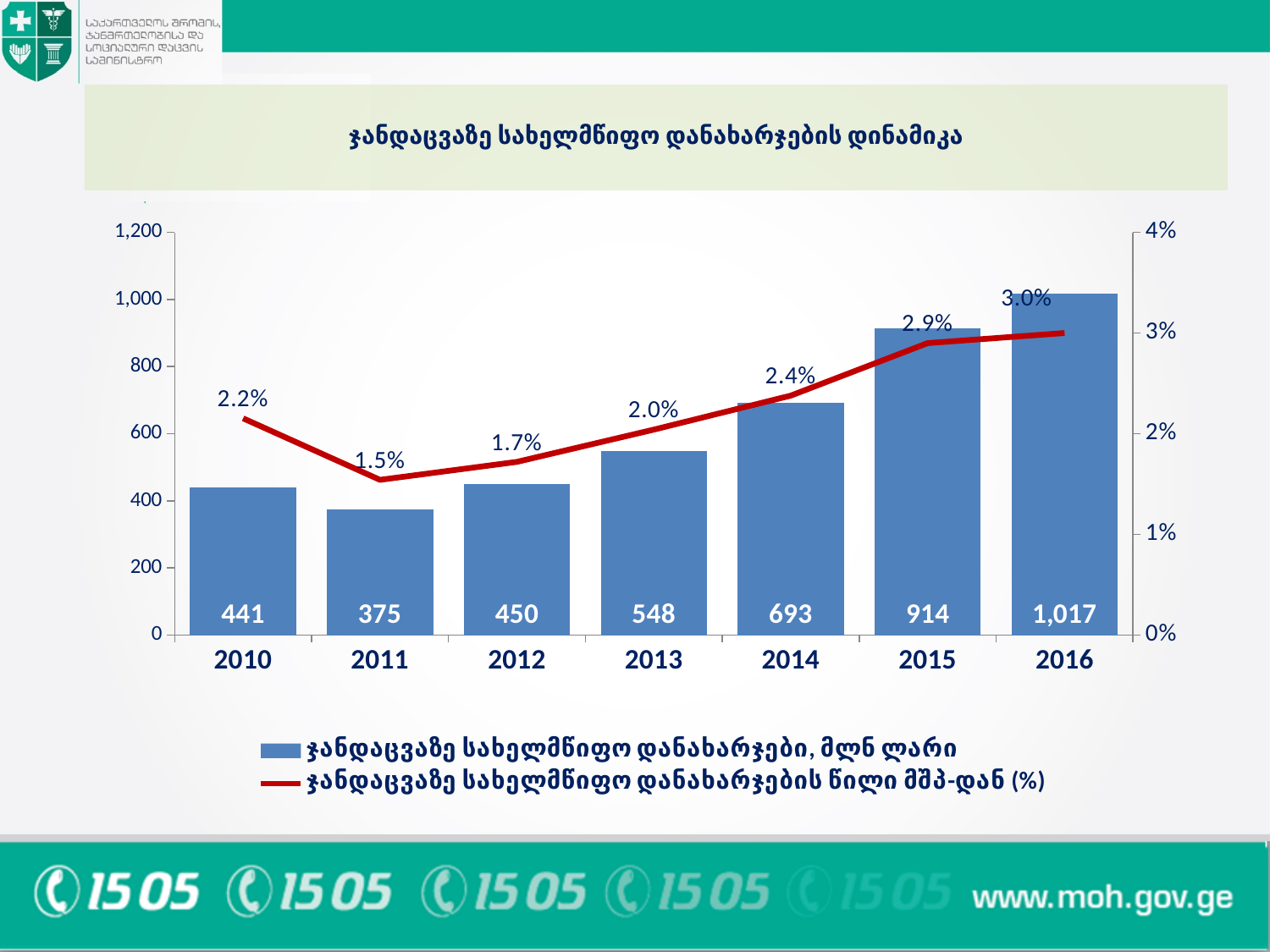
Do the bar values rise or fall from 2011 to 2016? Rise What kind of chart is shown on the slide? Combined bar and line chart Which year has the lowest bar value? 2011 What is the value of the line (share of GDP) for 2012? 1.7% How many series does the legend list? 2 How many years are shown on the x axis? 7 Which year has the lowest value on the line series? 2011 Which is larger, the bar value for 2013 or the bar value for 2012? 2013 What is the difference between the line values for 2015 and 2010? 0.7% What is the value of the bar for 2014? 693 Which year has the highest bar value? 2016 What is the difference between the bar values for 2016 and 2015? 103